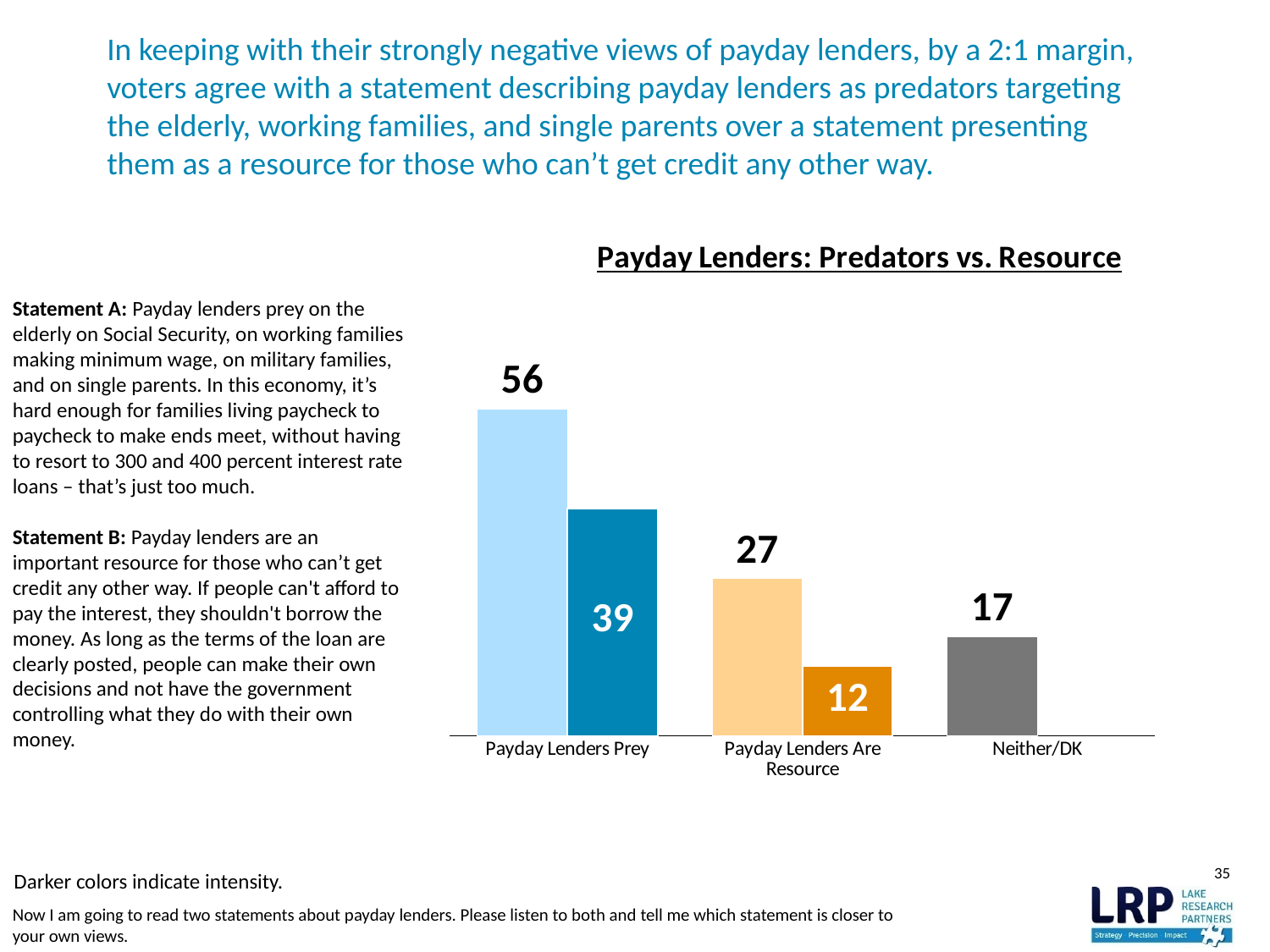
What type of chart is shown on the slide? Bar chart What is the difference between the total for Payday Lenders Prey and the total for Payday Lenders Are Resource? 29 How many categories are shown along the x axis of the chart? 3 What is the darker (intensity) value shown for Payday Lenders Are Resource? 12 Which category has the highest total value in the chart? Payday Lenders Prey What is the darker (intensity) value shown for Payday Lenders Prey? 39 What is the total value shown for Payday Lenders Prey in the Payday Lenders: Predators vs. Resource chart? 56 What is the total value shown for Payday Lenders Are Resource? 27 Which is larger: the total for Payday Lenders Are Resource or the value for Neither/DK? Payday Lenders Are Resource What is the value shown for Neither/DK? 17 What is the difference between the darker values for Payday Lenders Prey and Payday Lenders Are Resource? 27